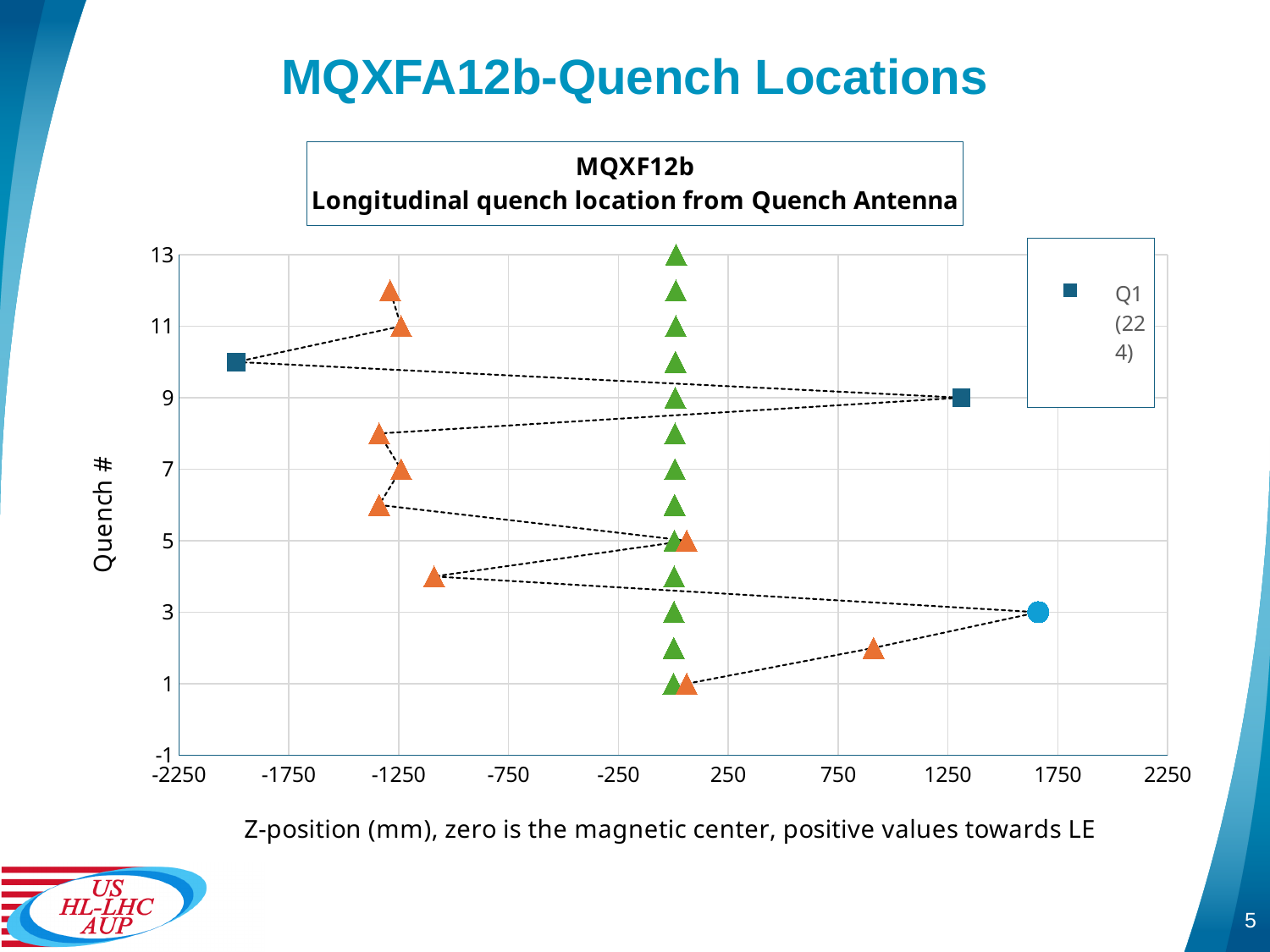
Is the Z-position for quench 9 greater or less than 750? greater Which has the larger Z-position, quench 3 or quench 9? quench 3 Is the Z-position for quench 12 greater or less than -750? less Which quench number has the lowest (most negative) Z-position? 10 Is the Z-position for quench 3 greater or less than 1250? greater What is the label of the x axis? Z-position (mm), zero is the magnetic center, positive values towards LE Which quench number has the highest Z-position? 3 What is the title of the chart? MQXF12b Longitudinal quench location from Quench Antenna What kind of chart is shown on the slide? scatter chart